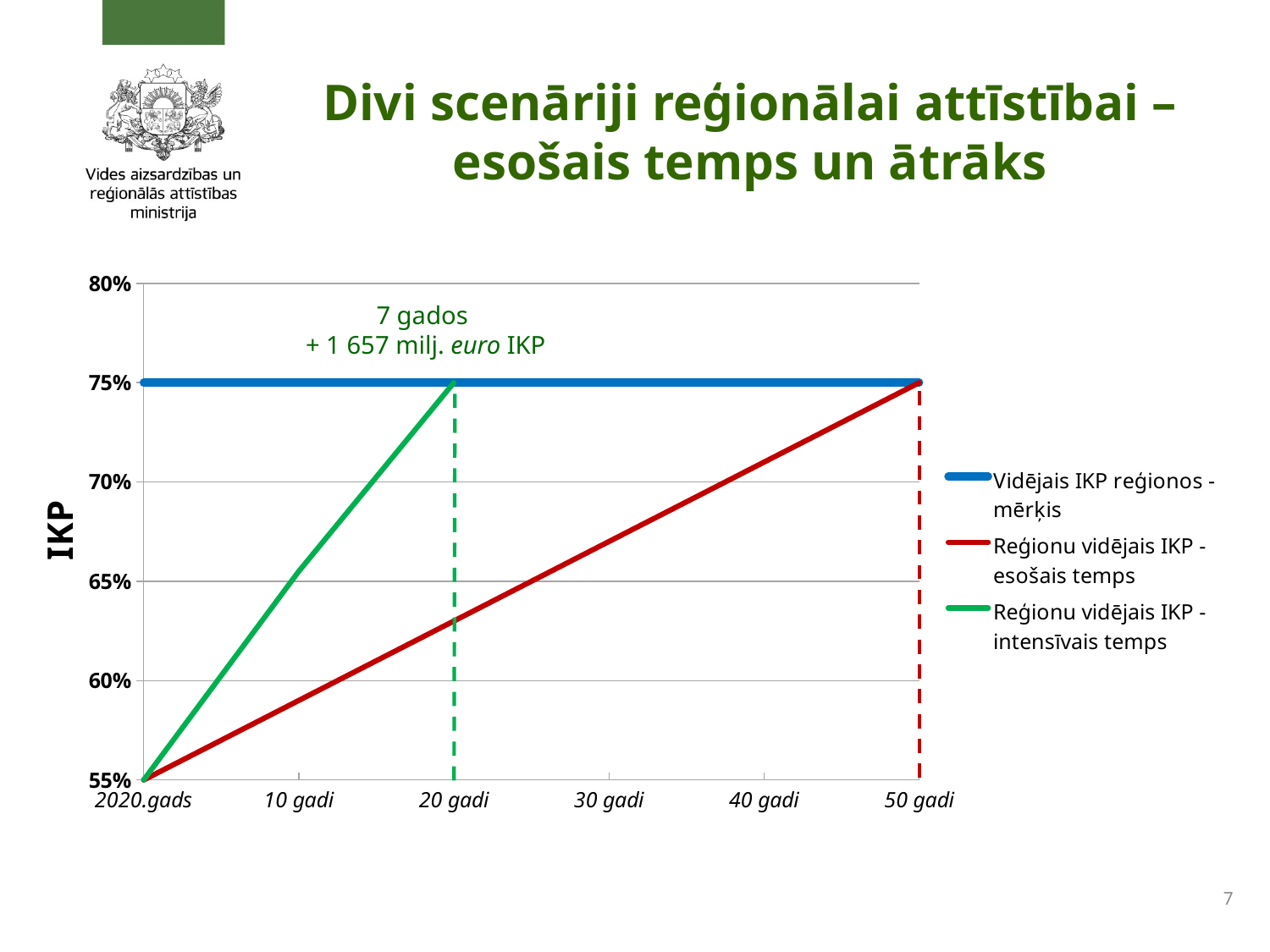
What is the label of the y axis? IKP What is the value of "Reģionu vidējais IKP - esošais temps" at 50 gadi? 75% At 10 gadi, which series is higher: "Reģionu vidējais IKP - esošais temps" or "Reģionu vidējais IKP - intensīvais temps"? Reģionu vidējais IKP - intensīvais temps How many series does the legend list? 3 Is the value of "Reģionu vidējais IKP - esošais temps" at 20 gadi greater or less than 65%? less What is the value of the series "Vidējais IKP reģionos - mērķis" across the whole chart? 75% Is the value of "Reģionu vidējais IKP - intensīvais temps" at 10 gadi greater or less than 60%? greater What is the value of "Reģionu vidējais IKP - intensīvais temps" at 2020.gads? 55% What kind of chart is shown on the slide? line chart Does the series "Reģionu vidējais IKP - esošais temps" rise or fall along the x axis? rise What colour is the line for "Reģionu vidējais IKP - intensīvais temps"? green What is the value of "Reģionu vidējais IKP - esošais temps" at 2020.gads? 55%